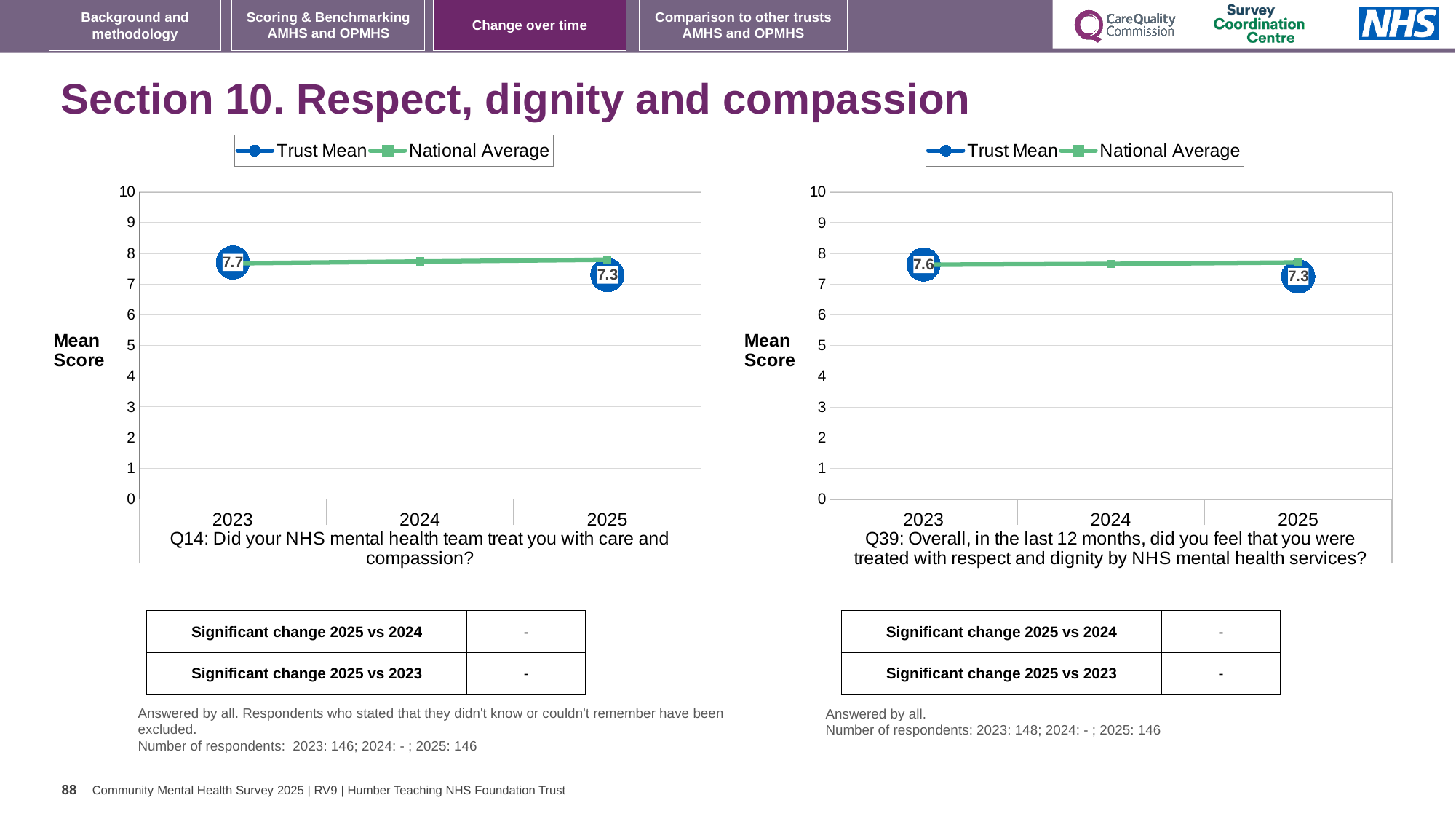
In the left chart (Q14), by how much did the Trust Mean fall from 2023 to 2025? 0.4 In the right chart (Q39), what is the difference between the Trust Mean in 2023 and in 2025? 0.3 In the right chart (Q39), does the Trust Mean rise or fall from 2023 to 2025? fall In the left chart (Q14), which is larger, the Trust Mean for 2023 or for 2025? 2023 How many years are shown on the x axis of the left chart (Q14)? 3 How many series does the legend of the right chart (Q39) list? 2 In the right chart (Q39), what is the Trust Mean score for 2025? 7.3 In the right chart (Q39), is the National Average for 2025 greater or less than 7? greater What kind of chart is the left chart (Q14)? line chart In the left chart (Q14), what is the Trust Mean score for 2025? 7.3 In the left chart (Q14), what is the Trust Mean score for 2023? 7.7 In the right chart (Q39), what is the Trust Mean score for 2023? 7.6